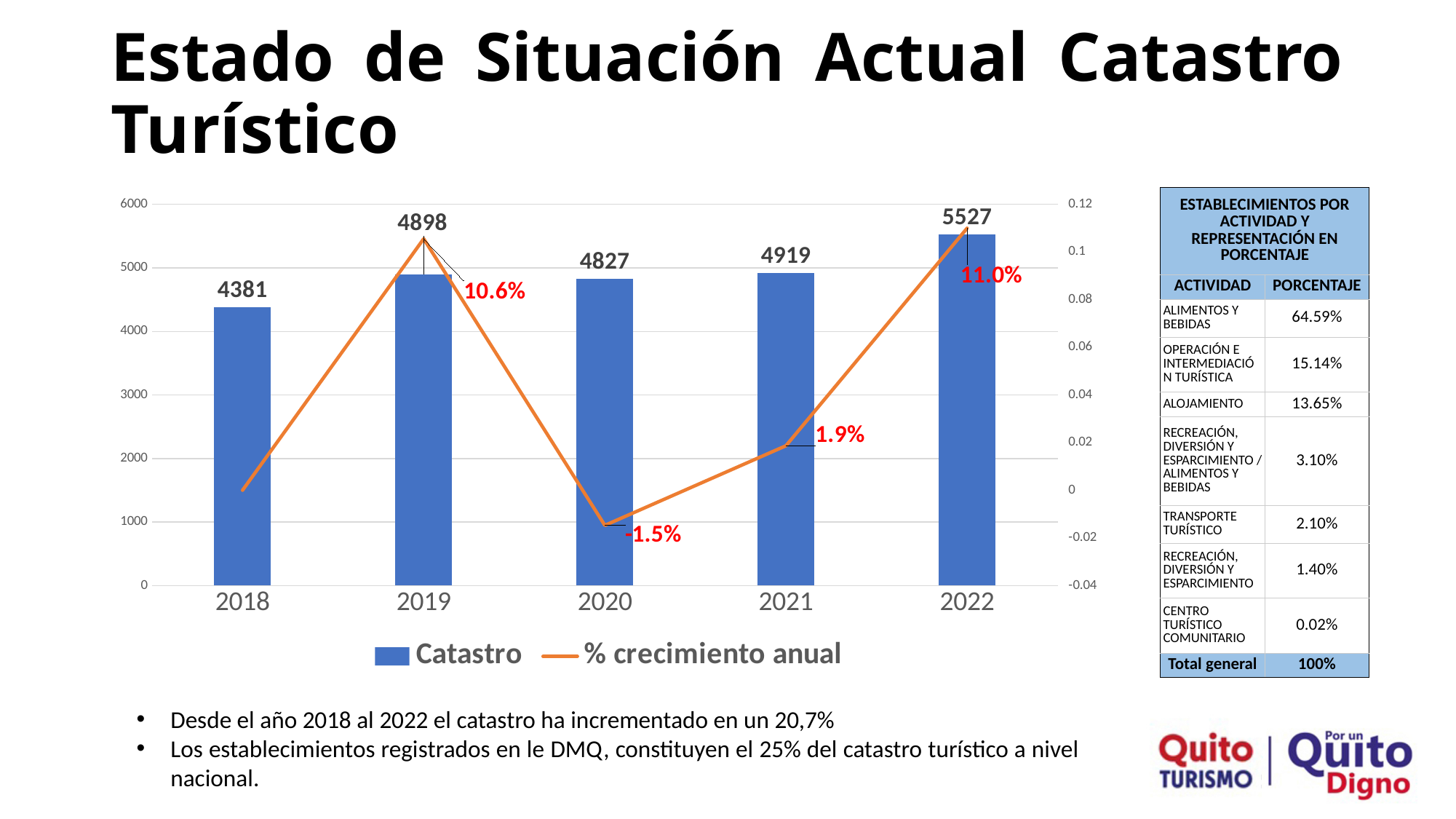
How many years are shown on the x axis of the chart? 5 How many series does the chart legend list? 2 Which year has the lowest Catastro value? 2018 Which series is drawn as an orange line in the chart? % crecimiento anual What is the difference between the Catastro values for 2022 and 2018? 1146 What is the % crecimiento anual value for 2020? -1.5% What is the % crecimiento anual value for 2021? 1.9% What is the Catastro value for 2022? 5527 Which year has the highest Catastro value? 2022 What is the Catastro value for 2018? 4381 Is the Catastro value for 2021 greater or less than 5000? less Which is larger, the Catastro value for 2019 or for 2020? 2019